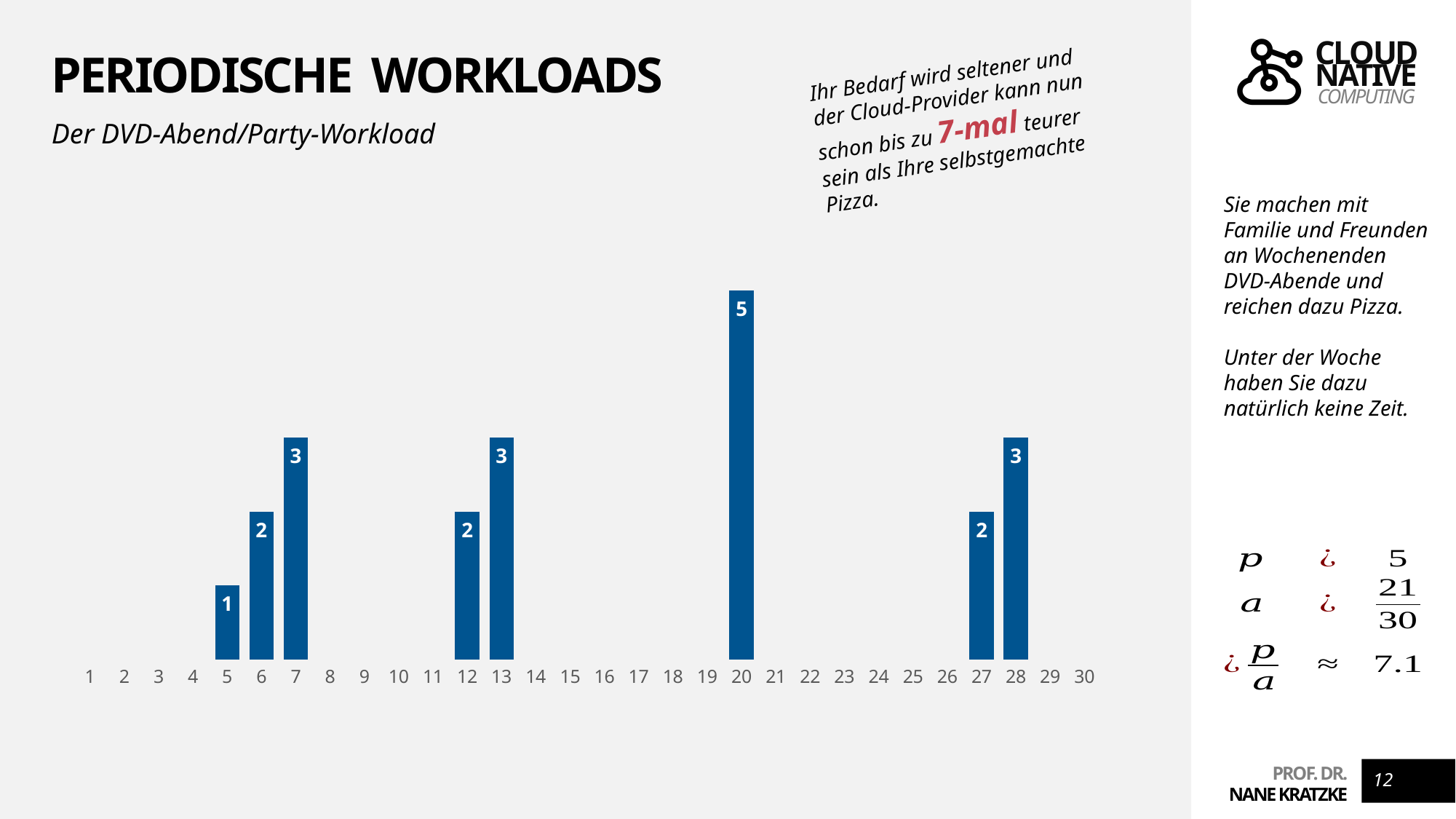
Which x-axis position has the lowest non-zero bar? 5 How many bars with a non-zero value are plotted in the chart? 8 What is the value of the bar at x = 5? 1 Which is larger, the bar at x = 6 or the bar at x = 28? the bar at x = 28 What is the value of the bar at x = 13? 3 What is the value of the bar at x = 20? 5 How many positions are labelled on the x axis? 30 What is the difference between the bar at x = 20 and the bar at x = 7? 2 What is the value of the bar at x = 27? 2 What kind of chart is shown on the slide? bar chart What is the total of the bars at x = 5, 6 and 7? 6 At which x-axis position is the highest bar? 20